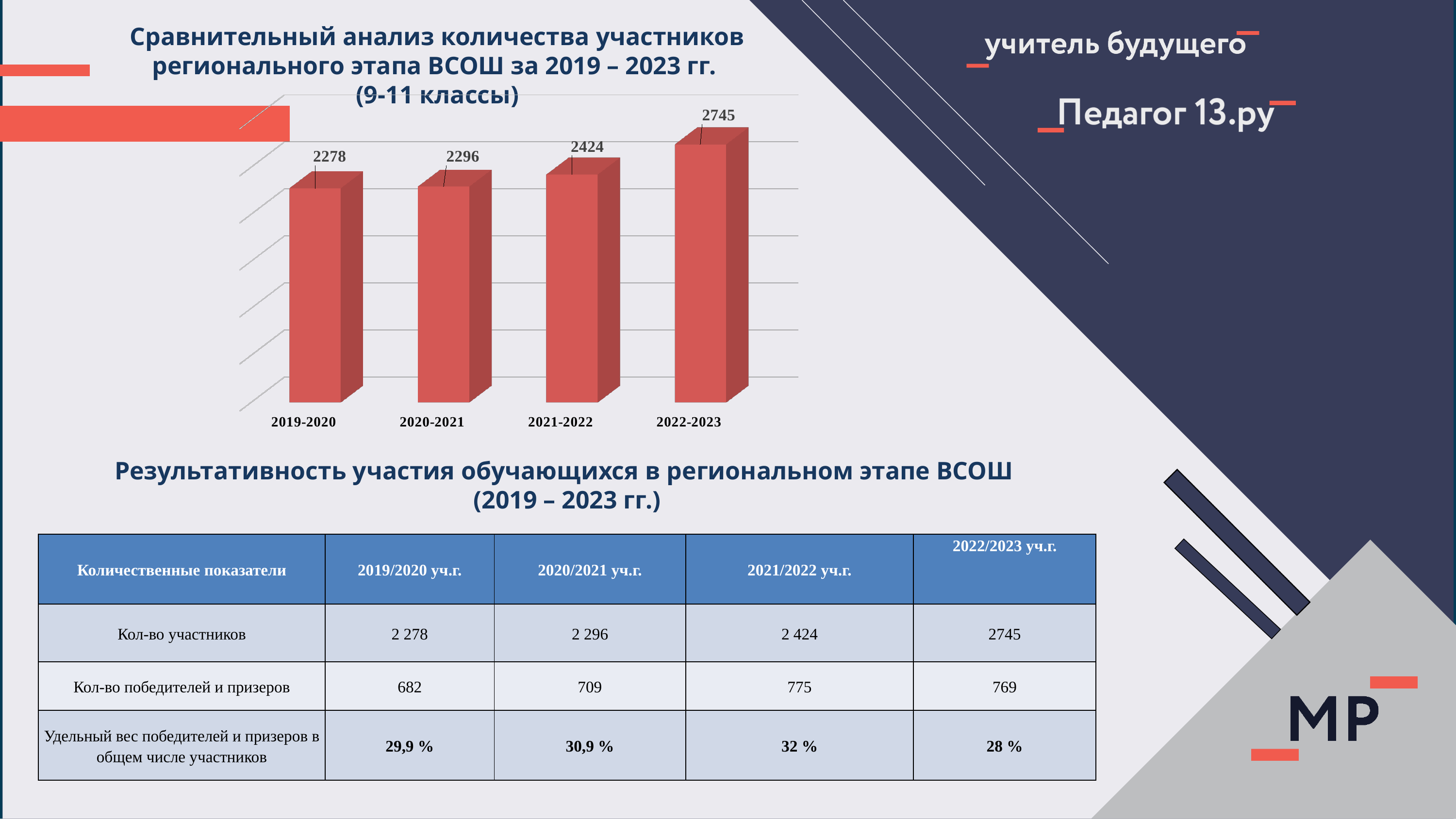
What is the number of participants shown for 2019-2020? 2278 Do the participant numbers rise or fall from 2019-2020 to 2022-2023? rise What is the difference in participants between 2020-2021 and 2019-2020? 18 What is the number of participants shown for 2022-2023? 2745 Which has more participants, 2021-2022 or 2020-2021? 2021-2022 Which academic year has the lowest number of participants in the chart? 2019-2020 What type of chart is used to show the number of participants? bar chart How many academic years are shown as bars in the chart? 4 What is the number of participants shown for 2020-2021? 2296 What is the number of participants shown for 2021-2022? 2424 Which academic year has the highest number of participants in the chart? 2022-2023 What is the difference in participants between 2022-2023 and 2021-2022? 321